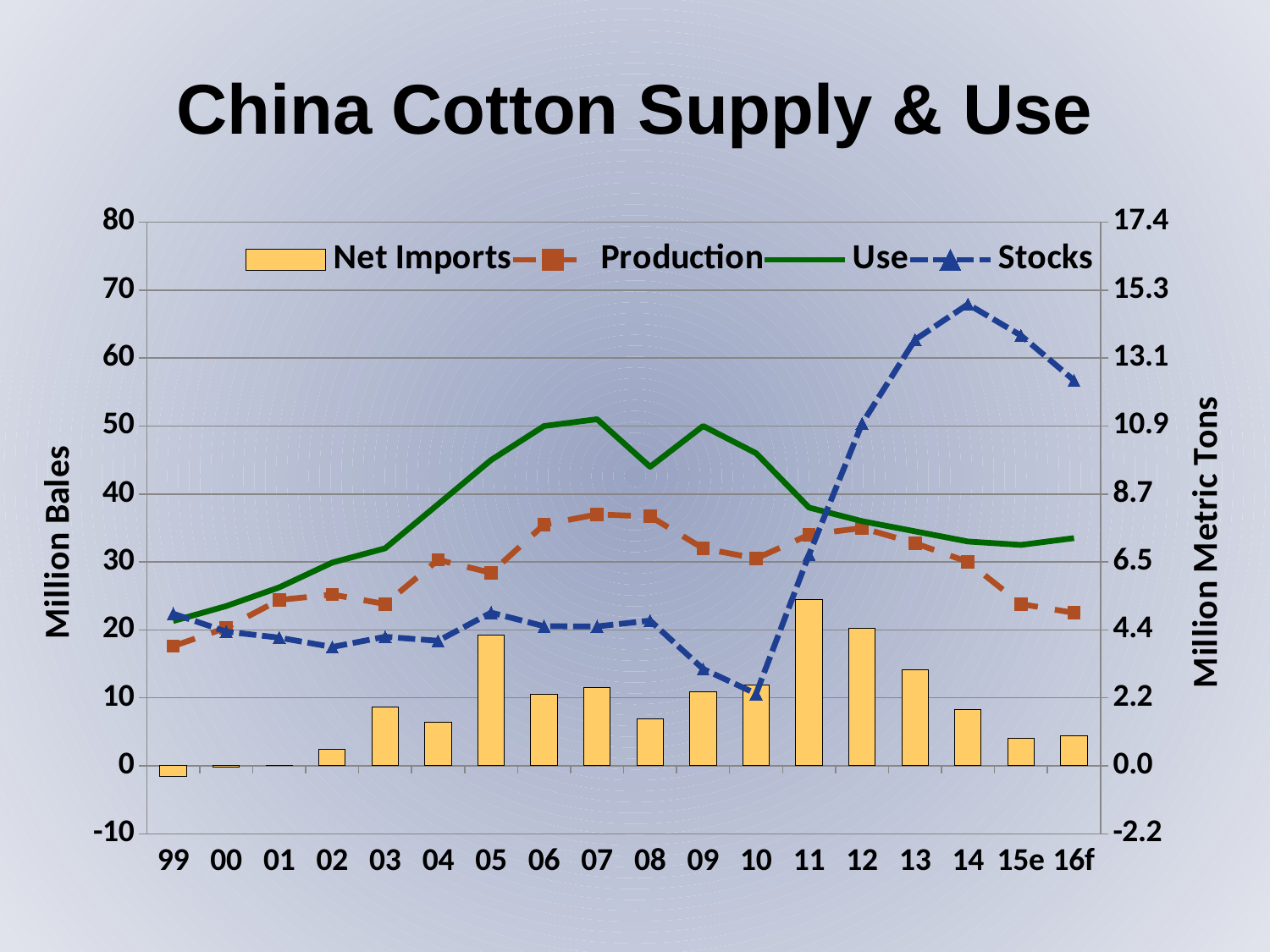
Is the value for Production in 07 greater or less than 30 million bales? greater In 10, which is larger, Production or Use? Use What is the label on the left vertical axis? Million Bales How many series does the legend list? 4 What kind of chart is shown on the slide? A combination bar and line chart Is the value for Net Imports in 05 greater or less than 10 million bales? greater Do Stocks rise or fall from 10 to 14? rise In which year are Net Imports highest? 11 How many years are shown along the x axis? 18 In which year do Stocks reach their peak? 14 Is the value for Use in 07 greater or less than 40 million bales? greater In which year are Net Imports lowest? 99